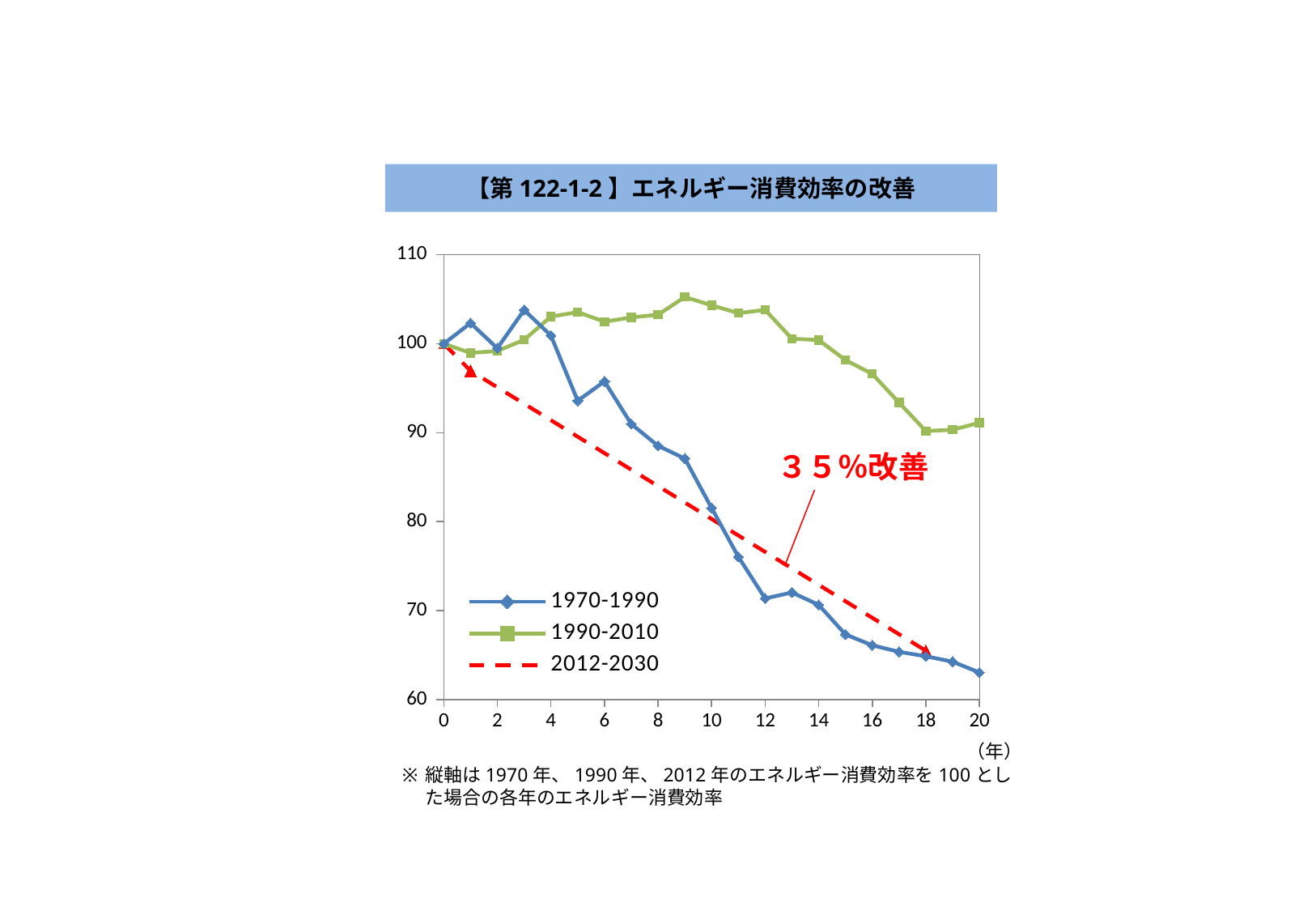
How many series does the legend list? 3 Which series has the lowest value at year 20? 1970-1990 What is the value of the 1970-1990 series at year 0? 100 Does the 1970-1990 series overall rise or fall from year 0 to year 20? fall Is the value of the 1970-1990 series at year 20 greater or less than 70? less What kind of chart is shown on the slide? line chart At year 20, which series has the higher value, 1970-1990 or 1990-2010? 1990-2010 Is the value of the 1990-2010 series at year 9 greater or less than 100? greater Which series is drawn as a red dashed line? 2012-2030 What is the title of the chart? 【第122-1-2】エネルギー消費効率の改善 Is the value of the 1970-1990 series at year 11 greater or less than 80? less